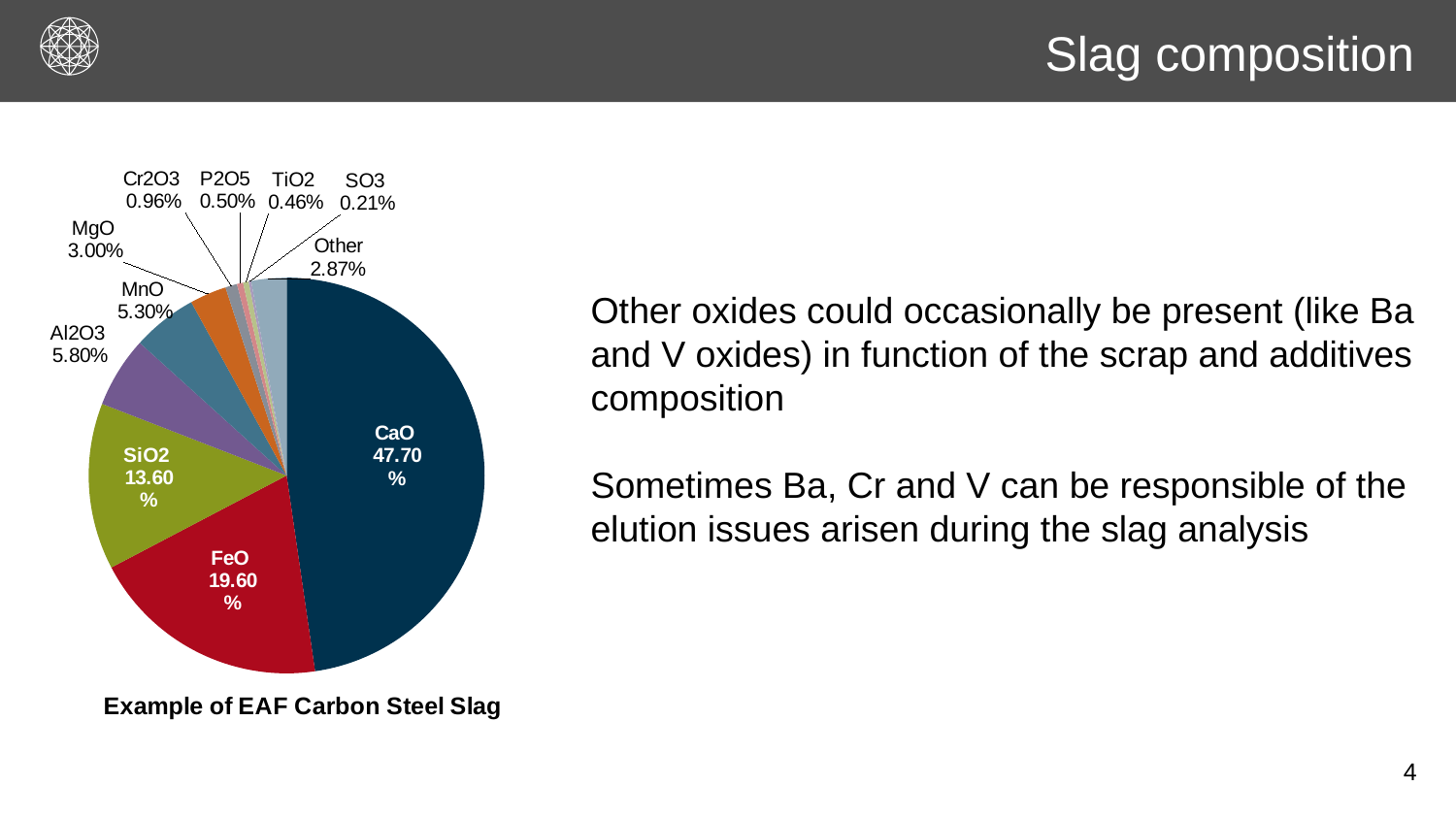
How many slices does the pie chart have? 11 What is the value shown for FeO? 19.60% What is the value shown for SO3? 0.21% Which is larger, the share of Al2O3 or the share of MgO? Al2O3 What is the title of the chart? Example of EAF Carbon Steel Slag Which component has the largest share of the pie? CaO What type of chart is shown on the slide? Pie chart Which component has the smallest share of the pie? SO3 What is the difference between the FeO and SiO2 shares? 6.00% What is the value shown for SiO2? 13.60% What is the value shown for MnO? 5.30% What share of the slag composition is CaO? 47.70%